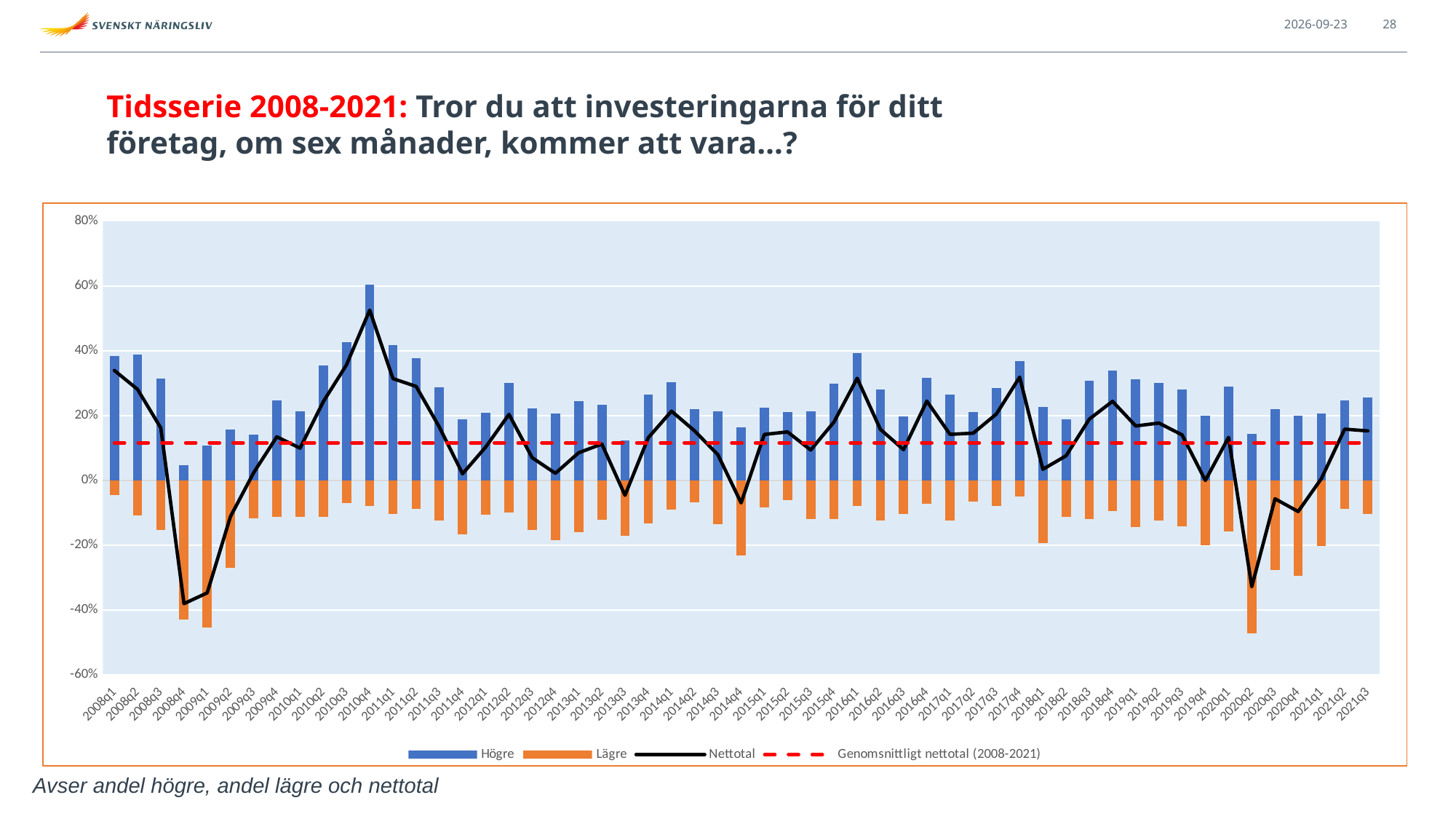
What kind of chart is shown on the slide? Bar chart with line series In which quarter does the Nettotal line reach its highest point? 2010q4 Is the Högre value for 2010q4 greater or less than 40%? greater Is the Högre value for 2008q4 greater or less than 20%? less Does the Nettotal line rise or fall from 2008q1 to 2008q4? fall Is the Lägre value for 2020q2 greater or less than -40%? less In which quarter is the Högre bar highest? 2010q4 In which quarter does the Lägre bar reach its lowest (most negative) value? 2020q2 Which is larger, the Högre value for 2008q1 or for 2008q4? 2008q1 How many quarters are plotted along the x axis? 55 What does the red dashed line represent according to the legend? Genomsnittligt nettotal (2008-2021) How many series does the legend list? 4